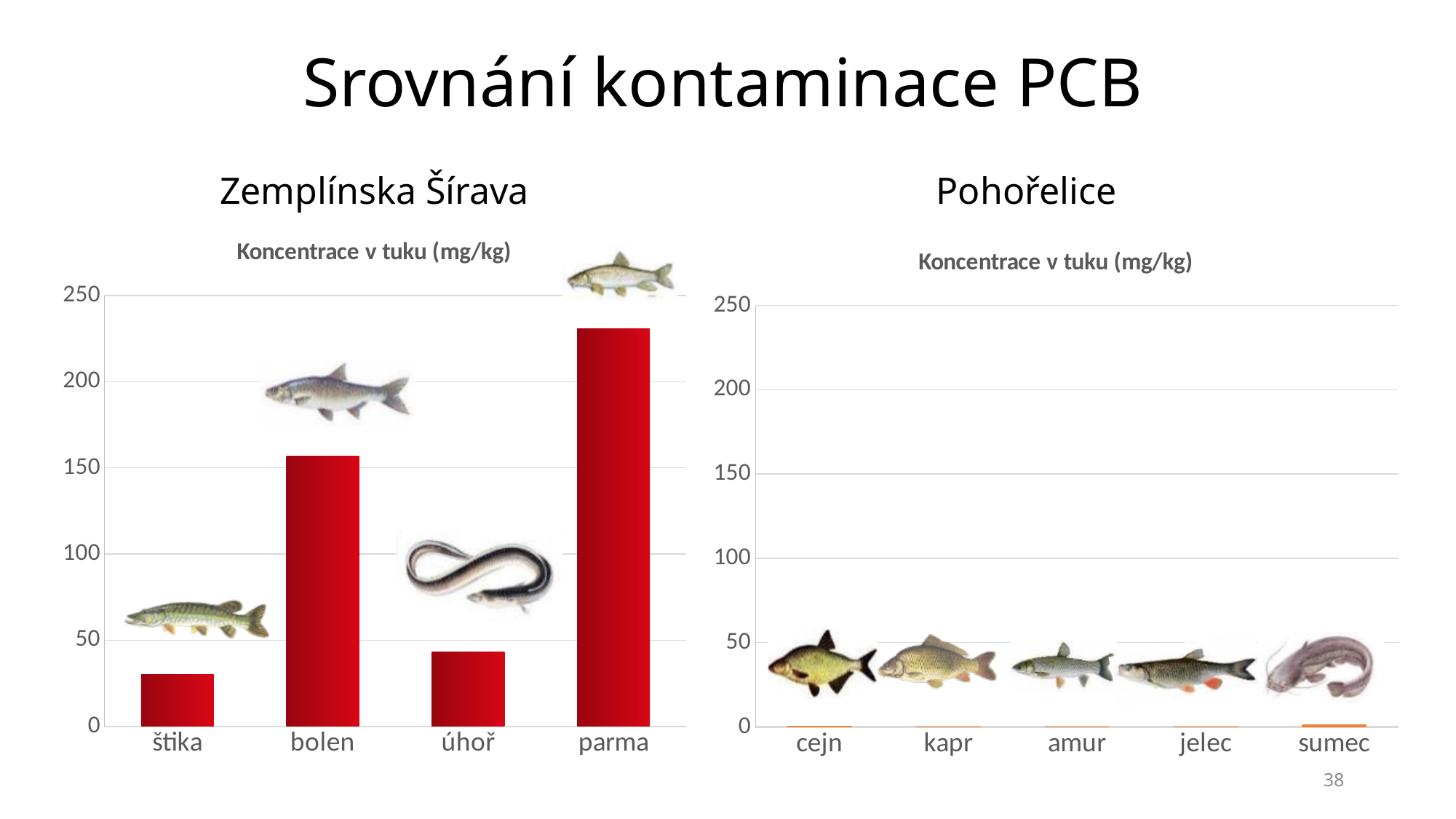
In the Zemplínska Šírava chart, is the value for parma greater or less than 200? greater In the Zemplínska Šírava chart, which fish has the highest concentration? parma How many fish categories are shown in the Zemplínska Šírava chart? 4 How many fish categories are shown in the Pohořelice chart? 5 In the Zemplínska Šírava chart, which has a higher value, bolen or úhoř? bolen In the Zemplínska Šírava chart, which fish has the lowest concentration? štika In the Pohořelice chart, is the value for kapr greater or less than 50? less What type of chart is the Zemplínska Šírava chart? bar chart What is the title shown above the Pohořelice chart's plot area? Koncentrace v tuku (mg/kg) In the Zemplínska Šírava chart, is the value for úhoř greater or less than 50? less